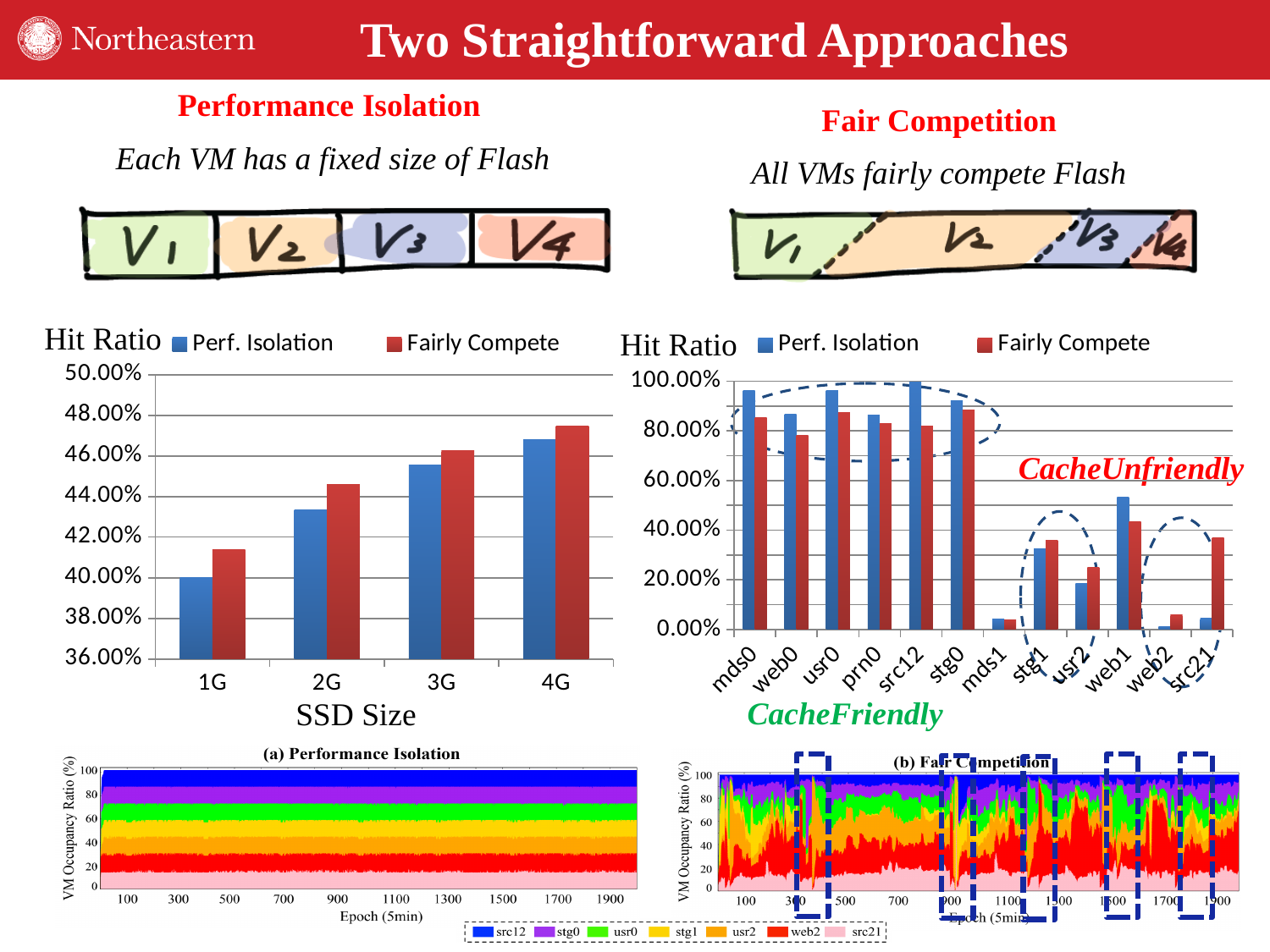
In the left 'Hit Ratio' bar chart (by SSD Size), is the Perf. Isolation value for 1G greater or less than 42.00%? less In the left 'Hit Ratio' bar chart (by SSD Size), how many series does the legend list? 2 In the left 'Hit Ratio' bar chart (by SSD Size), which series has the larger value at 2G, Perf. Isolation or Fairly Compete? Fairly Compete In the left 'Hit Ratio' bar chart (by SSD Size), do the Perf. Isolation values rise or fall as SSD size increases from 1G to 4G? rise In the right 'Hit Ratio' bar chart (by VM), which VM has the highest Perf. Isolation hit ratio? src12 In the right 'Hit Ratio' bar chart (by VM), how many VM categories are shown on the x axis? 12 In the right 'Hit Ratio' bar chart (by VM), is the Fairly Compete value for src21 greater or less than 20.00%? greater In the right 'Hit Ratio' bar chart (by VM), which series has the larger value for web1, Perf. Isolation or Fairly Compete? Perf. Isolation In the bottom '(a) Performance Isolation' chart, how many series does the shared legend below it list? 7 In the left 'Hit Ratio' bar chart (by SSD Size), is the Fairly Compete value for 4G greater or less than 46.00%? greater In the left 'Hit Ratio' bar chart (by SSD Size), how many SSD size categories are shown on the x axis? 4 In the right 'Hit Ratio' bar chart (by VM), which VM has the lowest Perf. Isolation hit ratio? web2